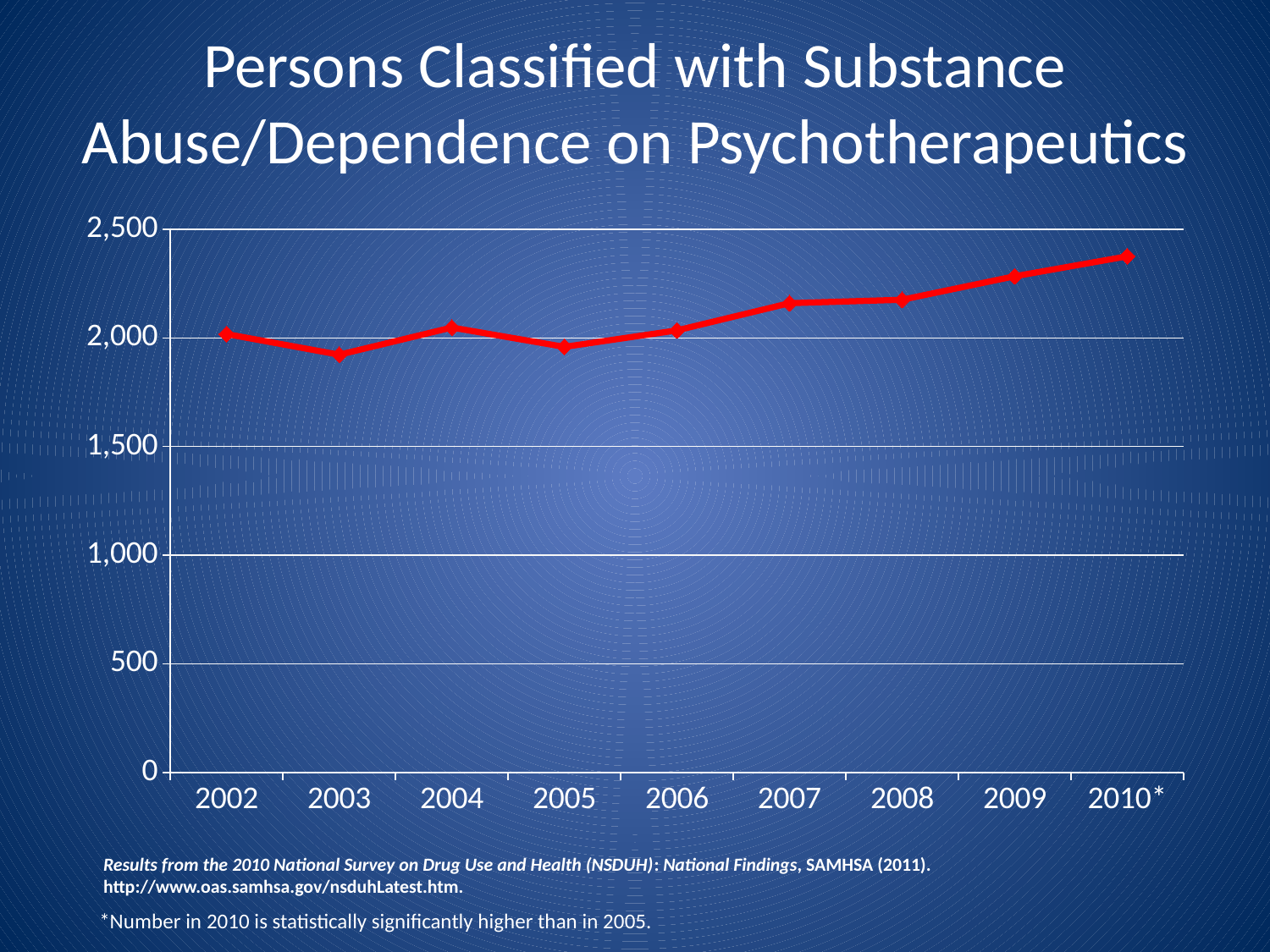
What kind of chart is shown on the slide? line chart Which year has the lowest value? 2003 Is the value for 2003 greater or less than 2,000? less Which is larger, the value for 2003 or the value for 2009? 2009 Is the value for 2009 greater or less than 2,000? greater Which year has the highest value? 2010* How many years are plotted on the x axis? 9 Do the values rise or fall from 2005 to 2010*? rise Which is larger, the value for 2002 or the value for 2010*? 2010* Is the value for 2007 greater or less than 1,500? greater What colour is the plotted line? red